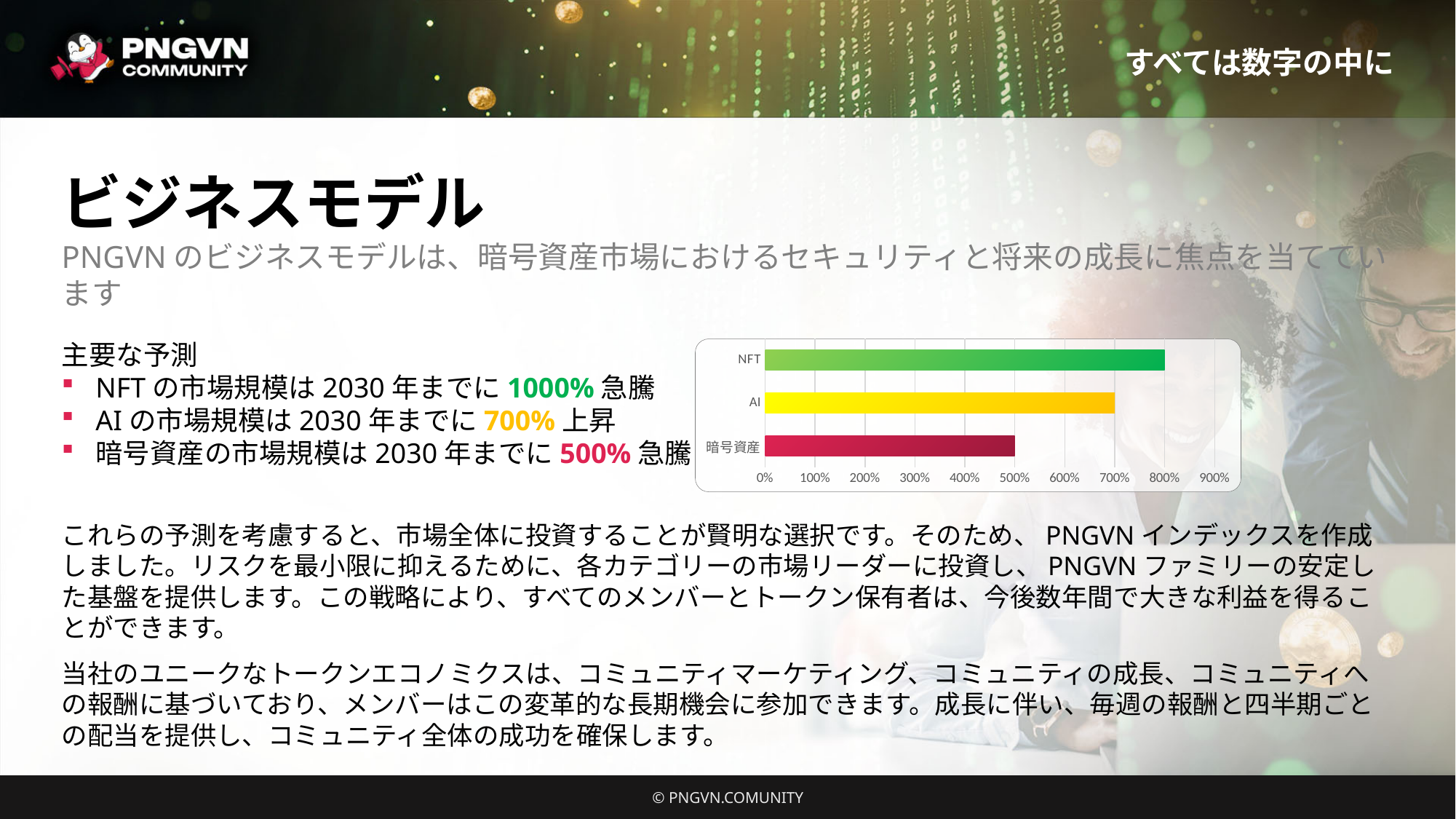
What colour is the bar for AI? yellow Is the value for NFT greater or less than 700%? greater What is the highest tick label shown on the chart's horizontal axis? 900% How many categories does the bar chart show? 3 What value does the bar for 暗号資産 reach on the axis? 500% What is the difference between the values for AI and 暗号資産? 200% Which is larger, the value for AI or the value for 暗号資産? AI Is the value for 暗号資産 greater or less than 600%? less What value does the bar for AI reach on the axis? 700% Which category has the longest bar in the chart? NFT Which category has the shortest bar in the chart? 暗号資産 What kind of chart is shown on the slide? bar chart